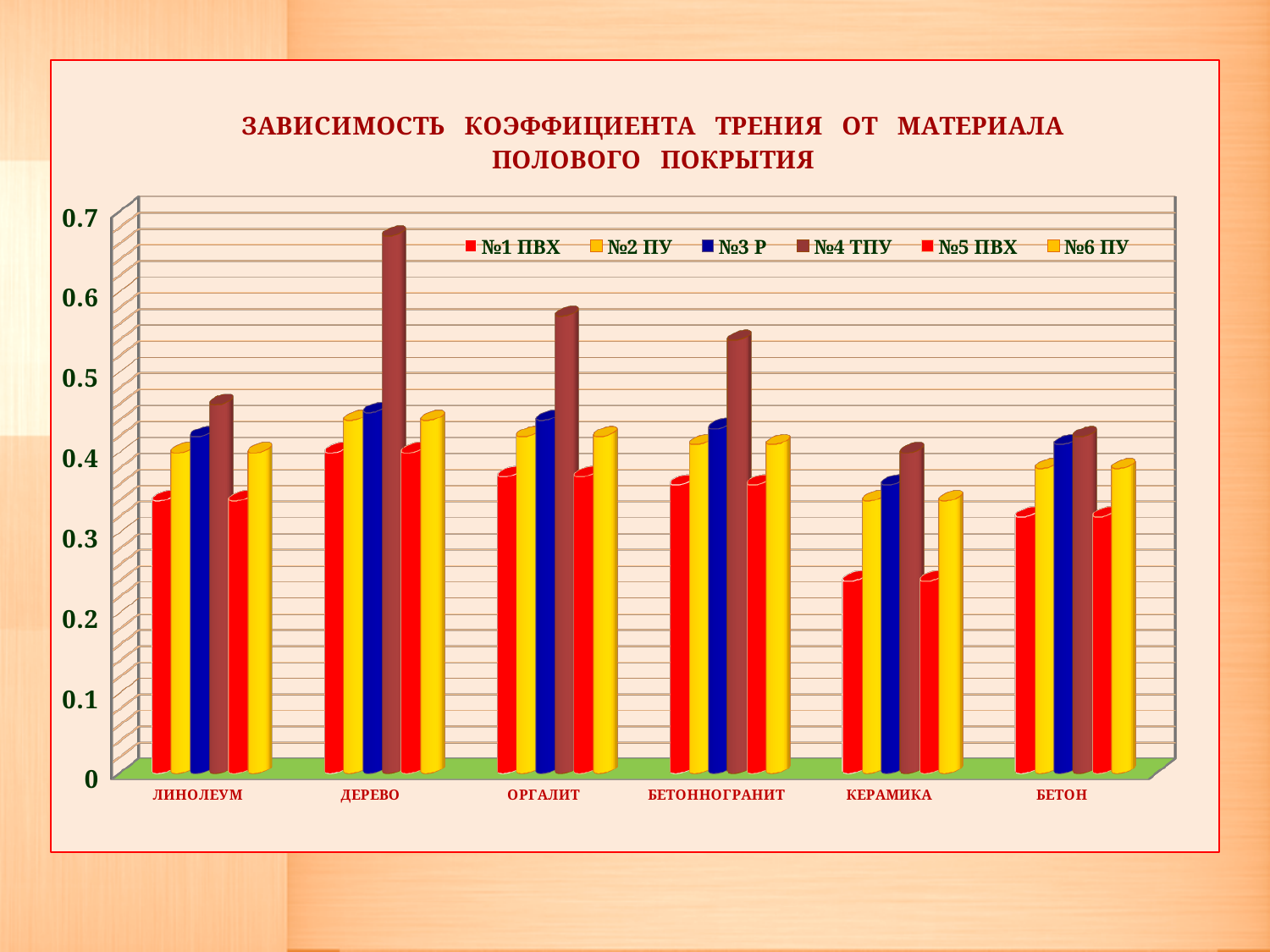
Is the value of №1 ПВХ for КЕРАМИКА greater or less than 0.3? less Which is larger: the №4 ТПУ value for ДЕРЕВО or for БЕТОН? ДЕРЕВО What is the title of the chart? ЗАВИСИМОСТЬ КОЭФФИЦИЕНТА ТРЕНИЯ ОТ МАТЕРИАЛА ПОЛОВОГО ПОКРЫТИЯ Is the value of №6 ПУ for БЕТОН greater or less than 0.3? greater For КЕРАМИКА, which is larger: the №4 ТПУ bar or the №1 ПВХ bar? №4 ТПУ For which material is the №1 ПВХ bar the lowest? КЕРАМИКА Is the value of №4 ТПУ for ДЕРЕВО greater or less than 0.6? greater What kind of chart is shown on the slide? bar chart For which material is the №4 ТПУ bar the highest? ДЕРЕВО How many floor-covering materials (categories) are shown on the x axis? 6 How many series does the legend list? 6 What colour are the №4 ТПУ bars? brown